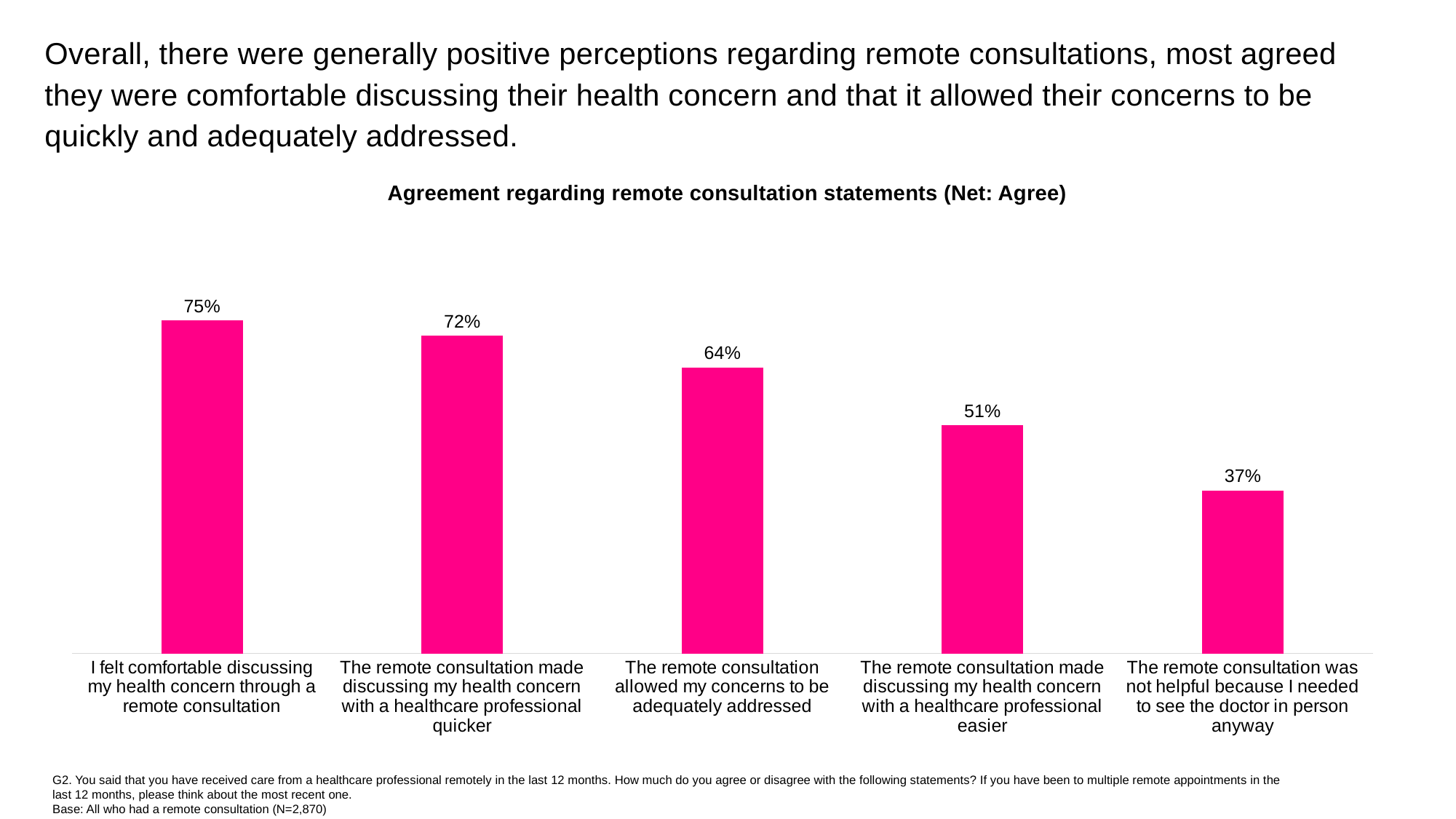
What is the value for 'The remote consultation made discussing my health concern with a healthcare professional easier'? 51% What is the title of the chart? Agreement regarding remote consultation statements (Net: Agree) What is the net agreement for 'The remote consultation allowed my concerns to be adequately addressed'? 64% Which statement has the lowest net agreement? The remote consultation was not helpful because I needed to see the doctor in person anyway What percentage agreed with the statement 'I felt comfortable discussing my health concern through a remote consultation'? 75% How many statements are shown in the chart? 5 Which has higher net agreement: 'The remote consultation made discussing my health concern with a healthcare professional quicker' or 'The remote consultation allowed my concerns to be adequately addressed'? The remote consultation made discussing my health concern with a healthcare professional quicker What is the difference in net agreement between 'I felt comfortable discussing my health concern through a remote consultation' and 'The remote consultation was not helpful because I needed to see the doctor in person anyway'? 38 percentage points What percentage agreed that 'The remote consultation was not helpful because I needed to see the doctor in person anyway'? 37% What type of chart is shown on the slide? Bar chart Which statement has the highest net agreement? I felt comfortable discussing my health concern through a remote consultation What is the difference between the net agreement for 'The remote consultation made discussing my health concern with a healthcare professional quicker' and for '...easier'? 21 percentage points